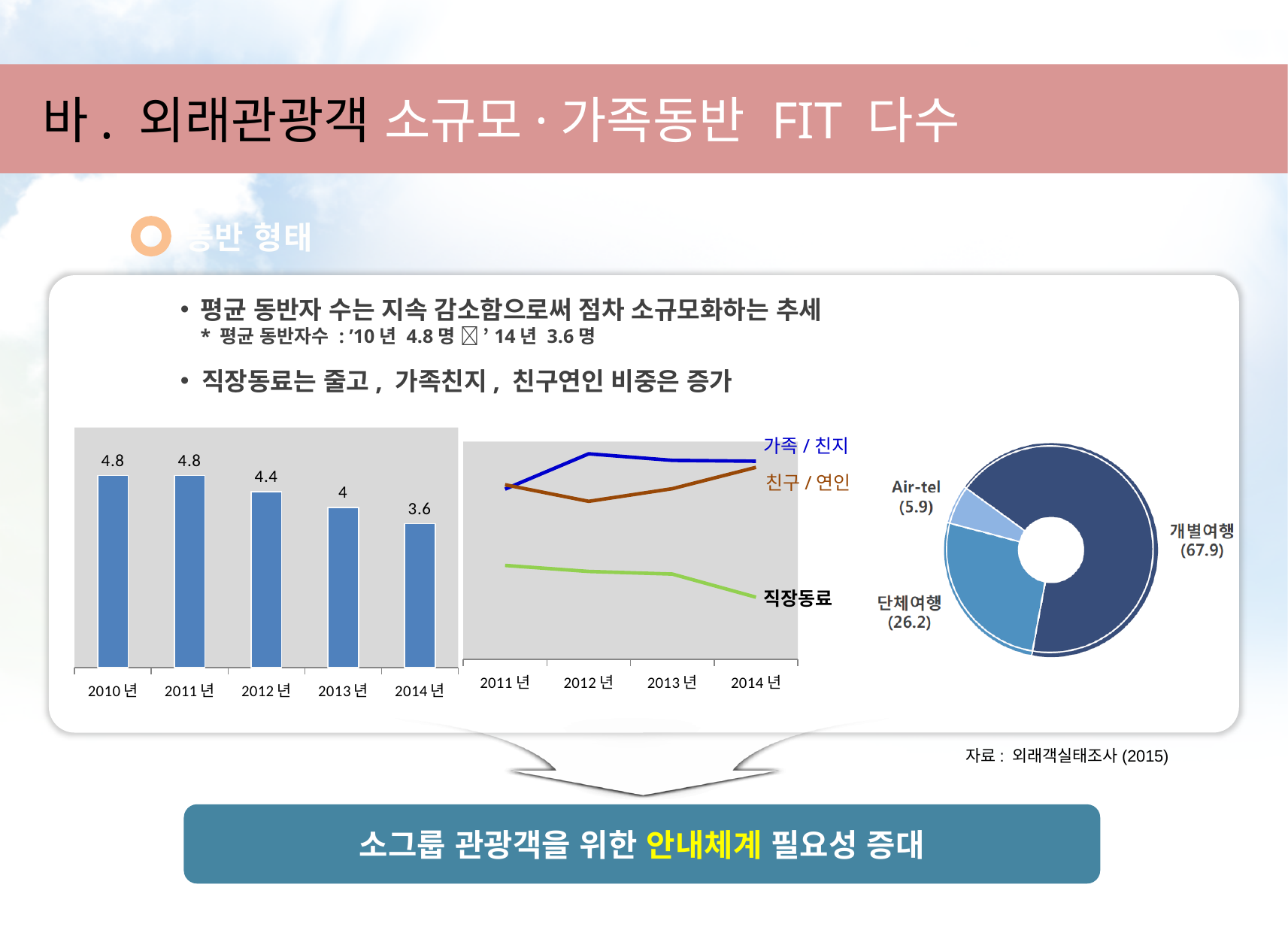
In the line chart in the middle, which series is lowest in 2014년? 직장동료 In the pie chart on the right, what is the value for 단체여행? 26.2 In the bar chart on the left, what is the value for 2012년? 4.4 In the bar chart on the left, do the values rise or fall from 2010년 to 2014년? fall In the bar chart on the left, what is the value for 2014년? 3.6 In the line chart in the middle, how many series are shown? 3 In the bar chart on the left, which year has the lowest value? 2014년 In the bar chart on the left, how many years are shown? 5 In the pie chart on the right, which category has the largest share? 개별여행 In the line chart in the middle, does the 직장동료 line rise or fall from 2011년 to 2014년? fall In the bar chart on the left, what is the difference between the values for 2010년 and 2014년? 1.2 What kind of chart is the chart on the left? bar chart